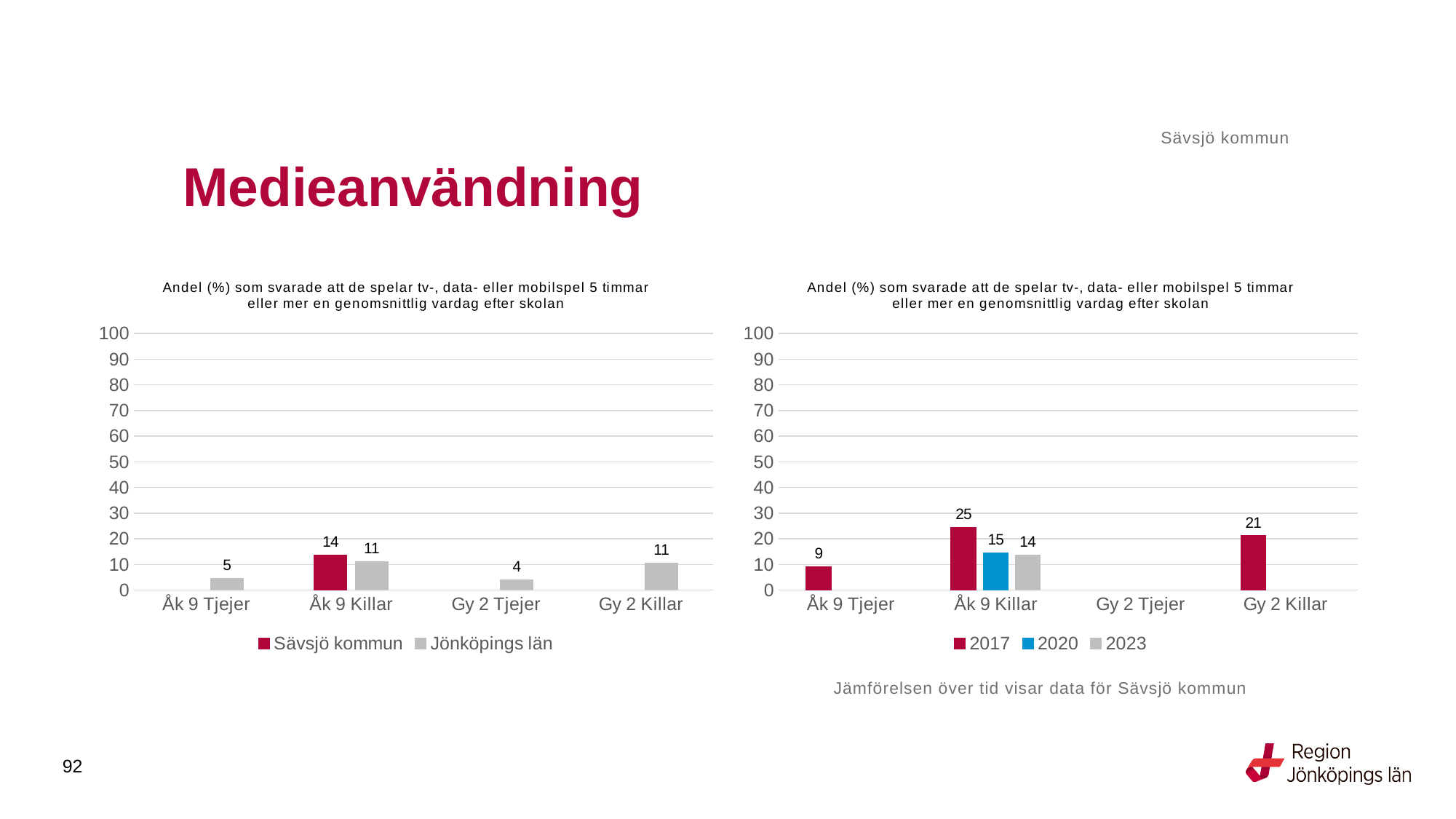
In the right chart, what is the value for 2017 for Åk 9 Killar? 25 In the right chart, which category has the highest value for 2017? Åk 9 Killar In the right chart, what is the value for 2020 for Åk 9 Killar? 15 In the left chart, what is the value for Jönköpings län for Åk 9 Killar? 11 In the left chart, how many series does the legend list? 2 In the right chart, is the 2017 value for Gy 2 Killar greater or less than 20? greater In the left chart, what is the value for Jönköpings län for Gy 2 Tjejer? 4 In the left chart, which category has the lowest value for Jönköpings län? Gy 2 Tjejer In the left chart, what is the value for Sävsjö kommun for Åk 9 Killar? 14 What kind of chart is the right chart? Bar chart In the right chart, what is the difference between the 2017 and 2023 values for Åk 9 Killar? 11 In the left chart, what is the difference between Sävsjö kommun and Jönköpings län for Åk 9 Killar? 3